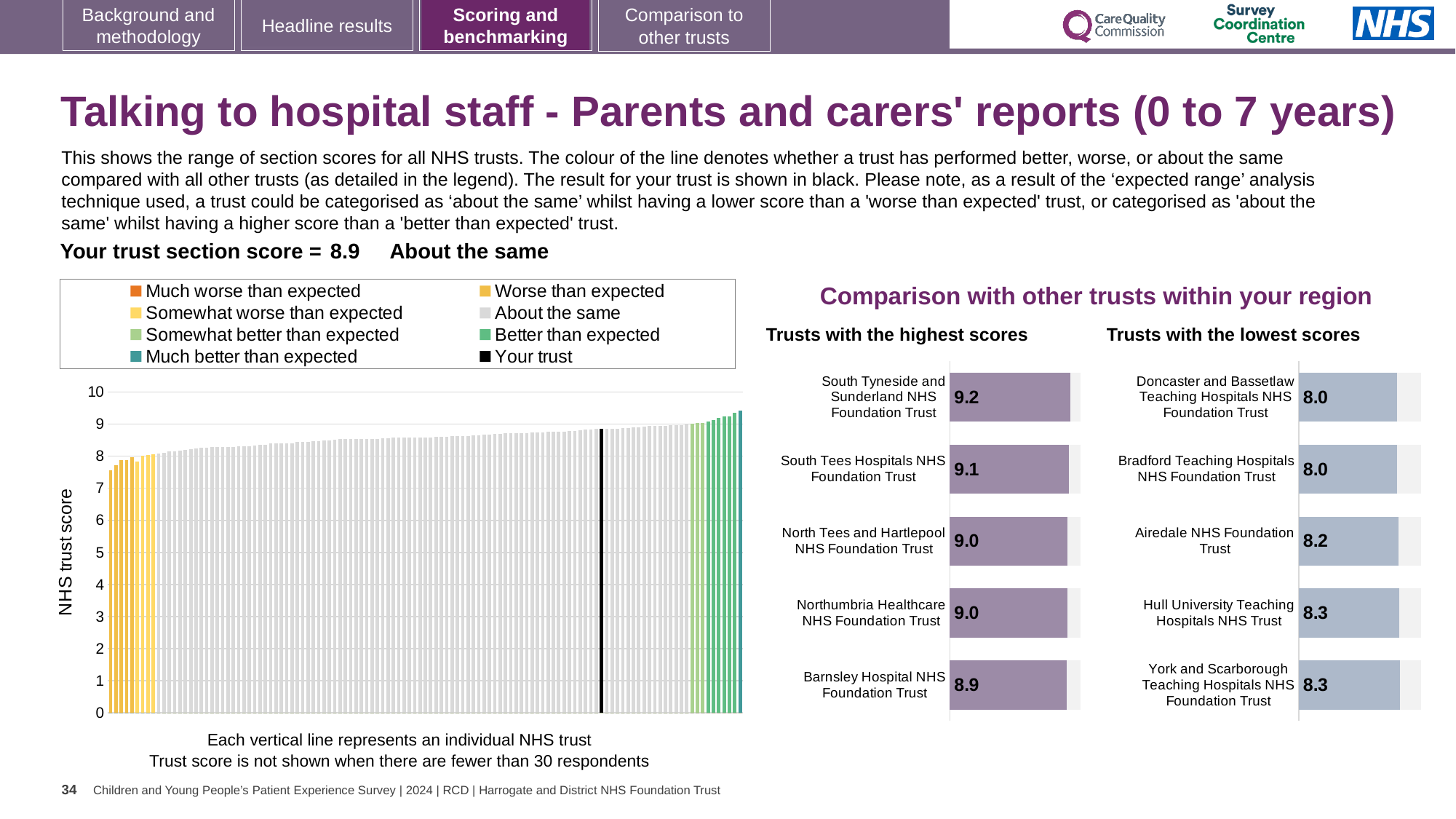
In the 'Trusts with the highest scores' chart, how many trusts are shown? 5 In the 'Trusts with the highest scores' chart, what is the score for South Tyneside and Sunderland NHS Foundation Trust? 9.2 In the 'Trusts with the lowest scores' chart, what is the difference between the scores of Airedale NHS Foundation Trust and Bradford Teaching Hospitals NHS Foundation Trust? 0.2 In the 'Trusts with the highest scores' chart, which trust has the lowest score? Barnsley Hospital NHS Foundation Trust In the 'Trusts with the lowest scores' chart, what is the score for Doncaster and Bassetlaw Teaching Hospitals NHS Foundation Trust? 8.0 In the 'Trusts with the lowest scores' chart, which has the larger score: Airedale NHS Foundation Trust or Hull University Teaching Hospitals NHS Trust? Hull University Teaching Hospitals NHS Trust In the 'Trusts with the highest scores' chart, what is the difference between the scores of South Tyneside and Sunderland NHS Foundation Trust and Barnsley Hospital NHS Foundation Trust? 0.3 In the 'Trusts with the highest scores' chart, which trust has the highest score? South Tyneside and Sunderland NHS Foundation Trust How many entries does the legend above the main chart on the left list? 8 In the main chart on the left showing all NHS trusts, do the trust scores rise or fall from left to right? rise In the main chart on the left showing all NHS trusts, what is the section score for your trust? 8.9 In the 'Trusts with the lowest scores' chart, what is the score for Airedale NHS Foundation Trust? 8.2